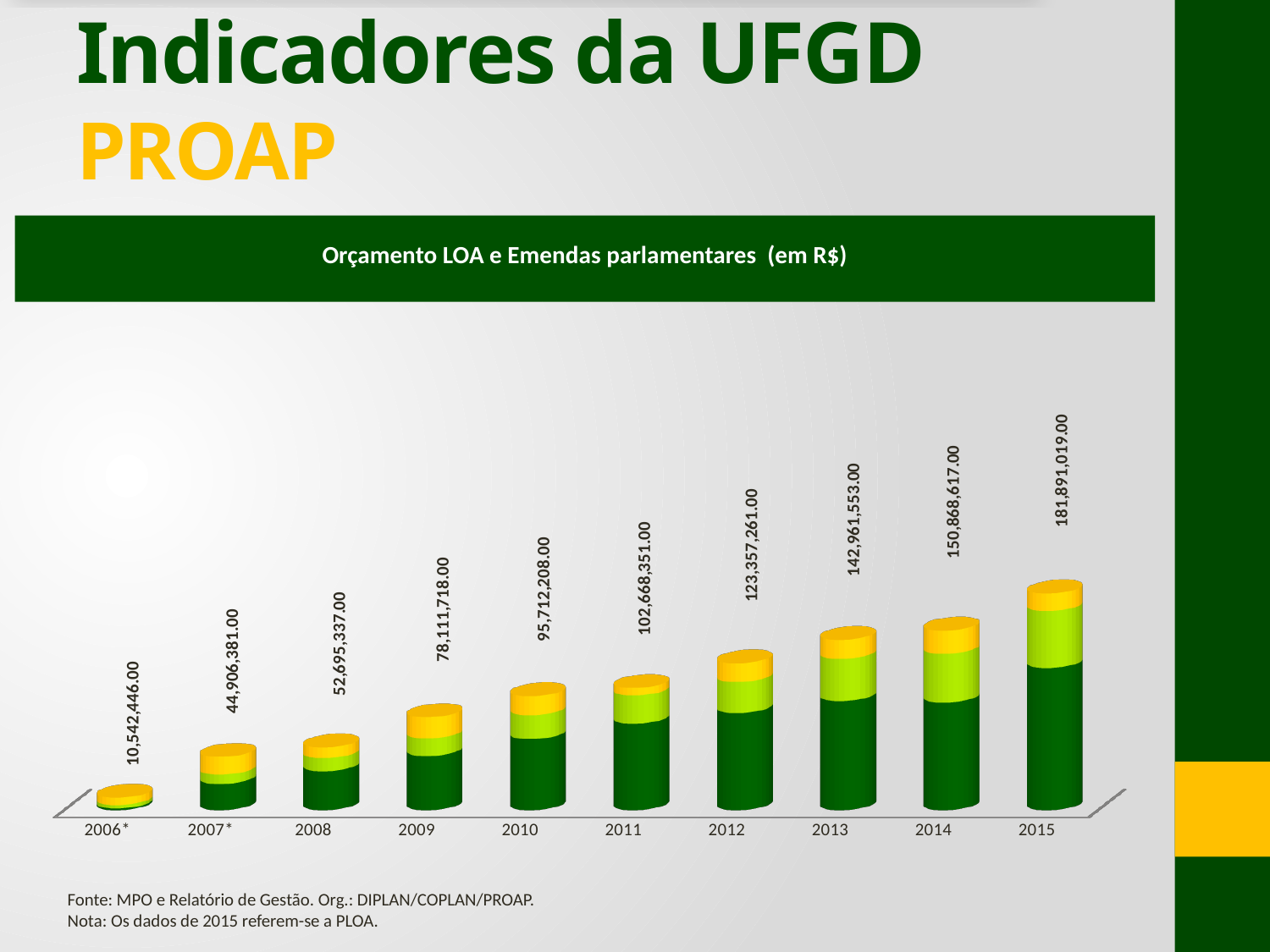
How many years are shown on the x axis? 10 What is the difference between the total values for 2008 and 2007*? 7,788,956.00 What is the total value shown for 2015? 181,891,019.00 Which is larger, the total value for 2010 or for 2012? 2012 Do the total values rise or fall from 2006* to 2015? Rise Which year has the lowest total value? 2006* What is the total value shown for 2011? 102,668,351.00 What is the total value shown for 2013? 142,961,553.00 Which year has the highest total value? 2015 What is the difference between the total values for 2015 and 2014? 31,022,402.00 What kind of chart is shown on the slide? Stacked bar chart What is the total value shown for 2006*? 10,542,446.00